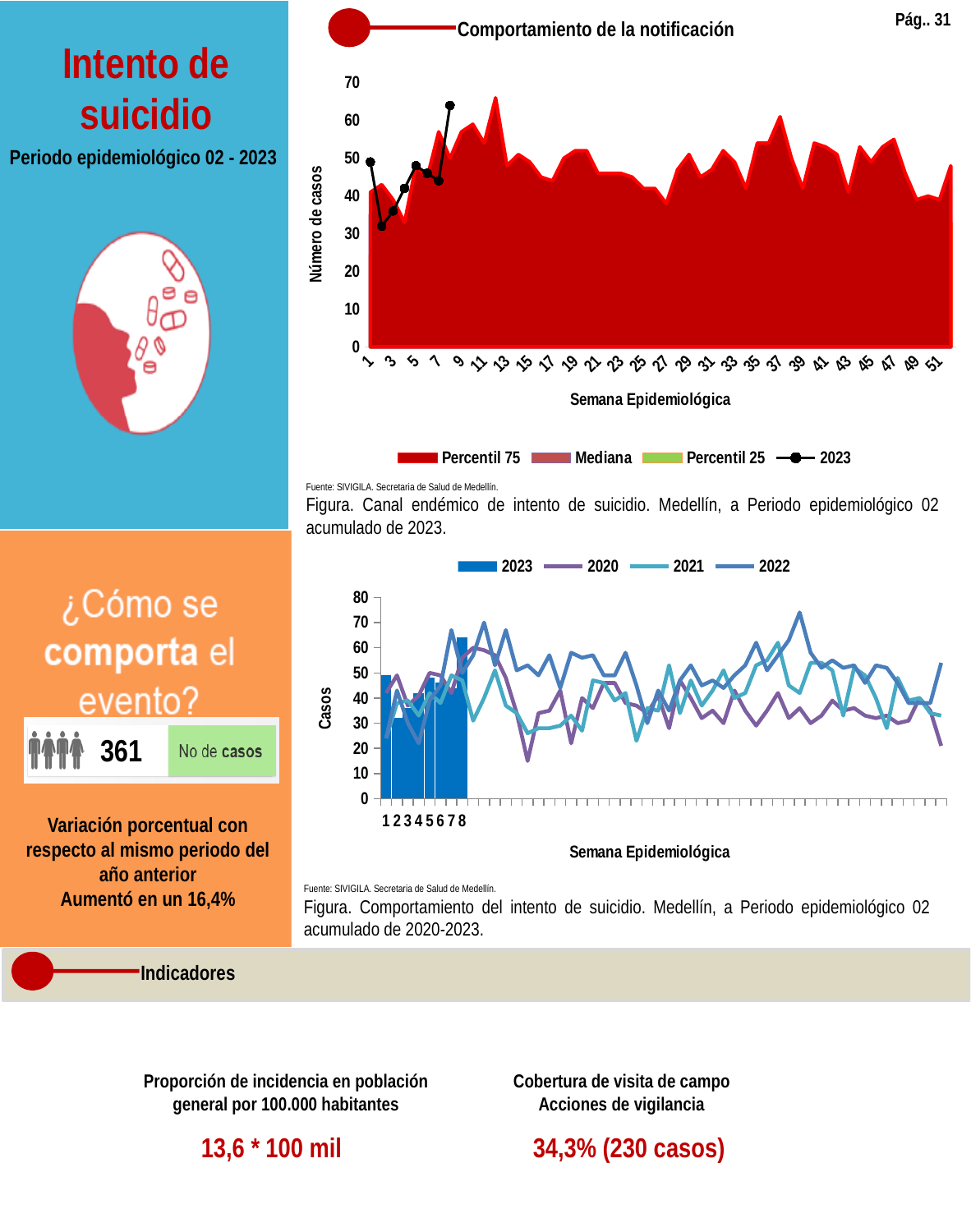
In the top chart 'Comportamiento de la notificación', at which week does the 2023 line reach its highest value? Week 8 In the top chart 'Comportamiento de la notificación', how many series does the legend list? 4 In the bottom chart (2020-2023), how many bars are plotted for the 2023 series? 8 In the bottom chart (2020-2023), which is larger: the 2023 bar for week 2 or the 2023 bar for week 8? Week 8 In the top chart 'Comportamiento de la notificación', what are the legend entries? Percentil 75, Mediana, Percentil 25, 2023 In the bottom chart (2020-2023), which week has the tallest 2023 bar? Week 8 In the top chart 'Comportamiento de la notificación', what is the label of the y axis? Número de casos In the bottom chart (2020-2023), how many series does the legend list? 4 In the top chart 'Comportamiento de la notificación', which is larger for the 2023 line: the value at week 1 or the value at week 8? Week 8 In the bottom chart (2020-2023), is the 2023 bar for week 8 greater or less than 60? greater In the top chart 'Comportamiento de la notificación', is the 2023 value at week 8 greater or less than 60? greater In the top chart 'Comportamiento de la notificación', is the 2023 value at week 2 greater or less than 40? less